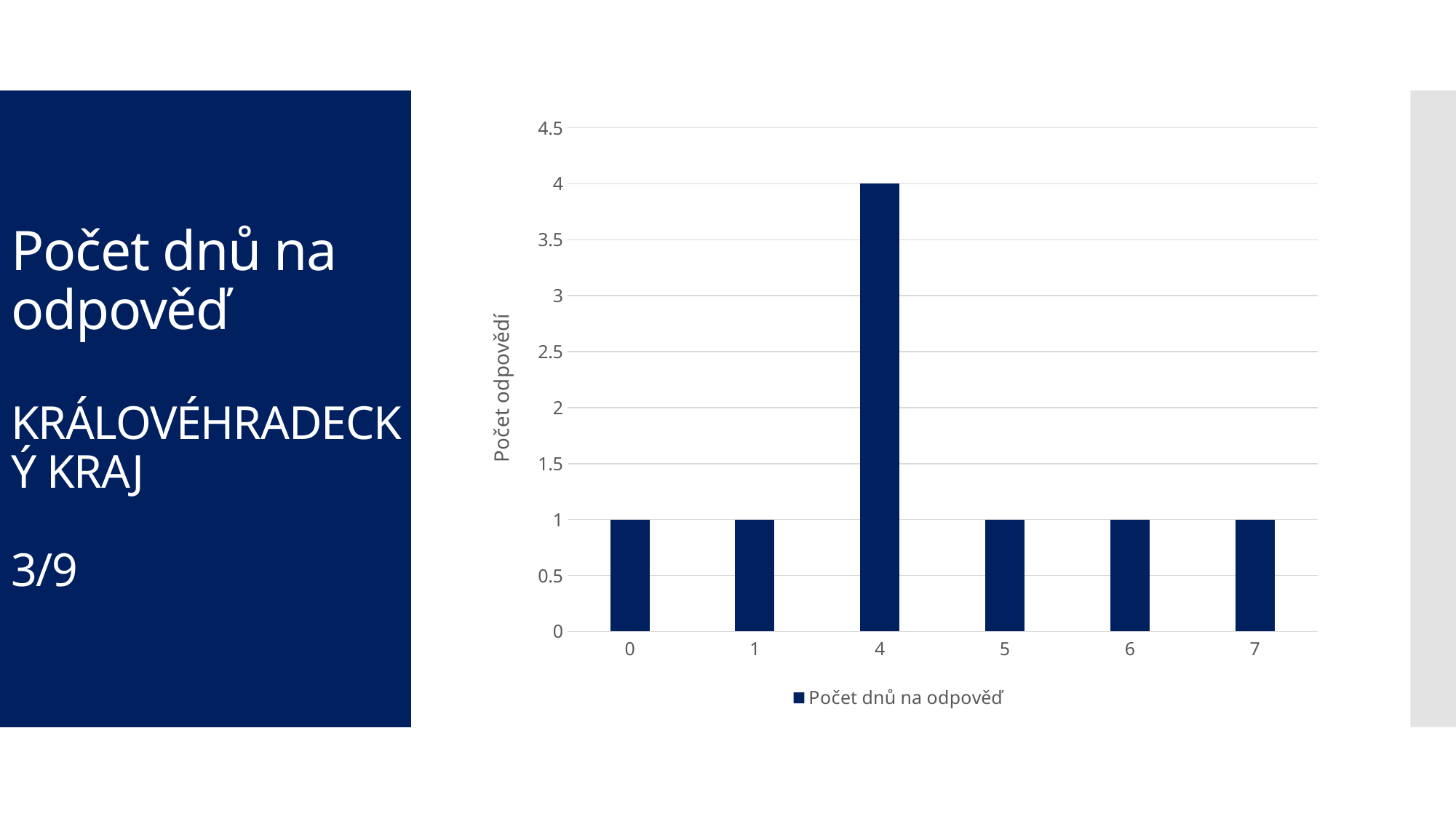
What kind of chart is shown on the slide? bar chart Which is larger, the value for category 4 or the value for category 6? category 4 What is the value for category 0 in the chart? 1 What series name is shown in the chart legend? Počet dnů na odpověď What is the difference between the values for category 4 and category 5? 3 What is the value for category 7 in the chart? 1 Is the value for category 4 greater or less than 3? greater How many categories are shown on the x axis of the chart? 6 How many series does the chart legend list? 1 Which category has the highest value in the chart? 4 What is the value for category 4 in the chart? 4 What is the label of the y axis of the chart? Počet odpovědí